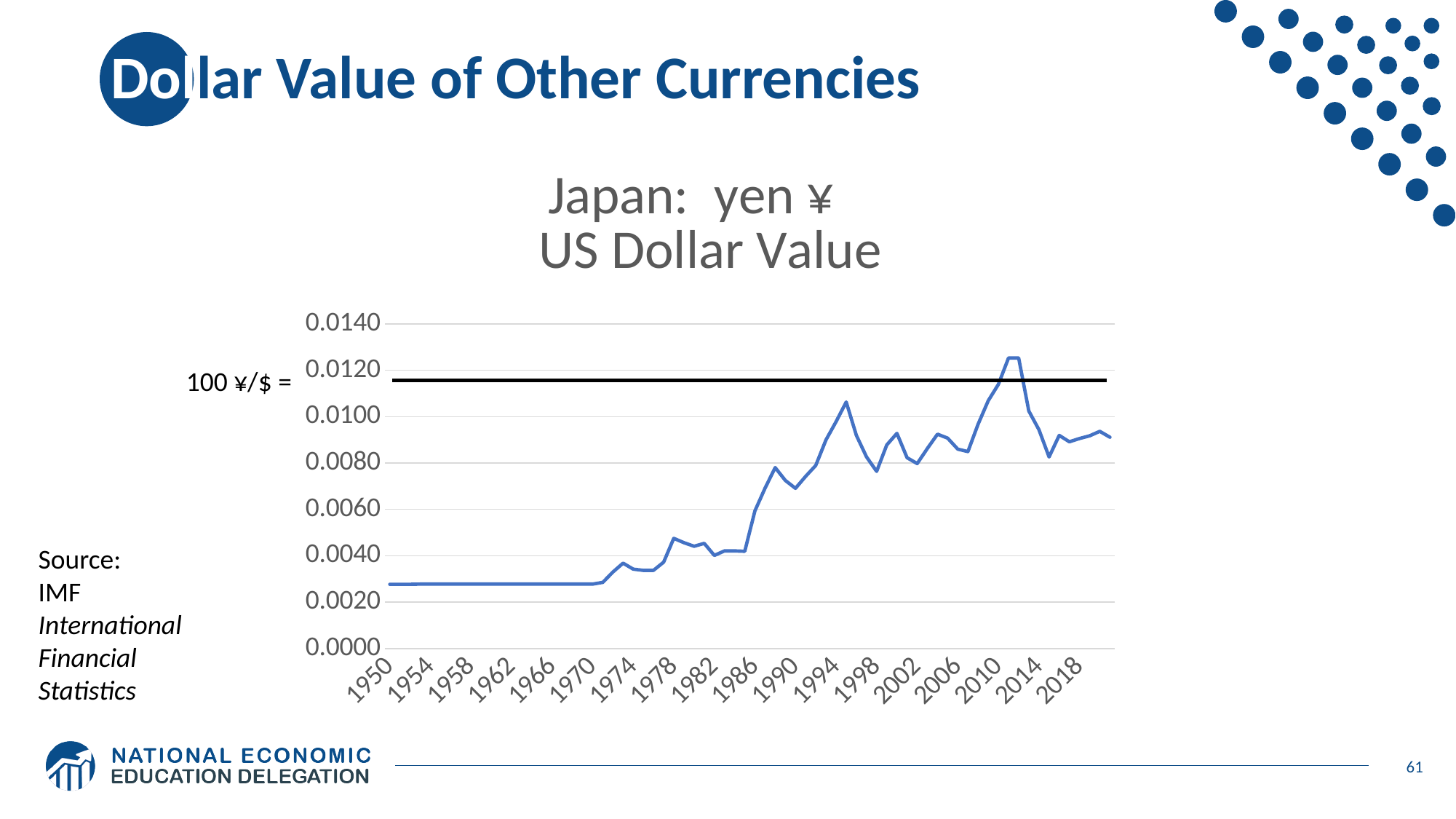
Is the value for 2018 greater or less than 0.0080? greater What label is attached to the black horizontal line on the chart? 100 ¥/$ = What is the title of the chart? Japan: yen ¥ US Dollar Value Which year has the larger value, 1970 or 1994? 1994 How many year labels are shown on the x axis? 18 Does the line reach its highest value before or after 2010? after Is the value for 1950 greater or less than 0.0040? less Is the value for 2018 greater or less than 0.0100? less Overall, does the line rise or fall from 1950 to 2018? rise What kind of chart is shown on the slide? line chart